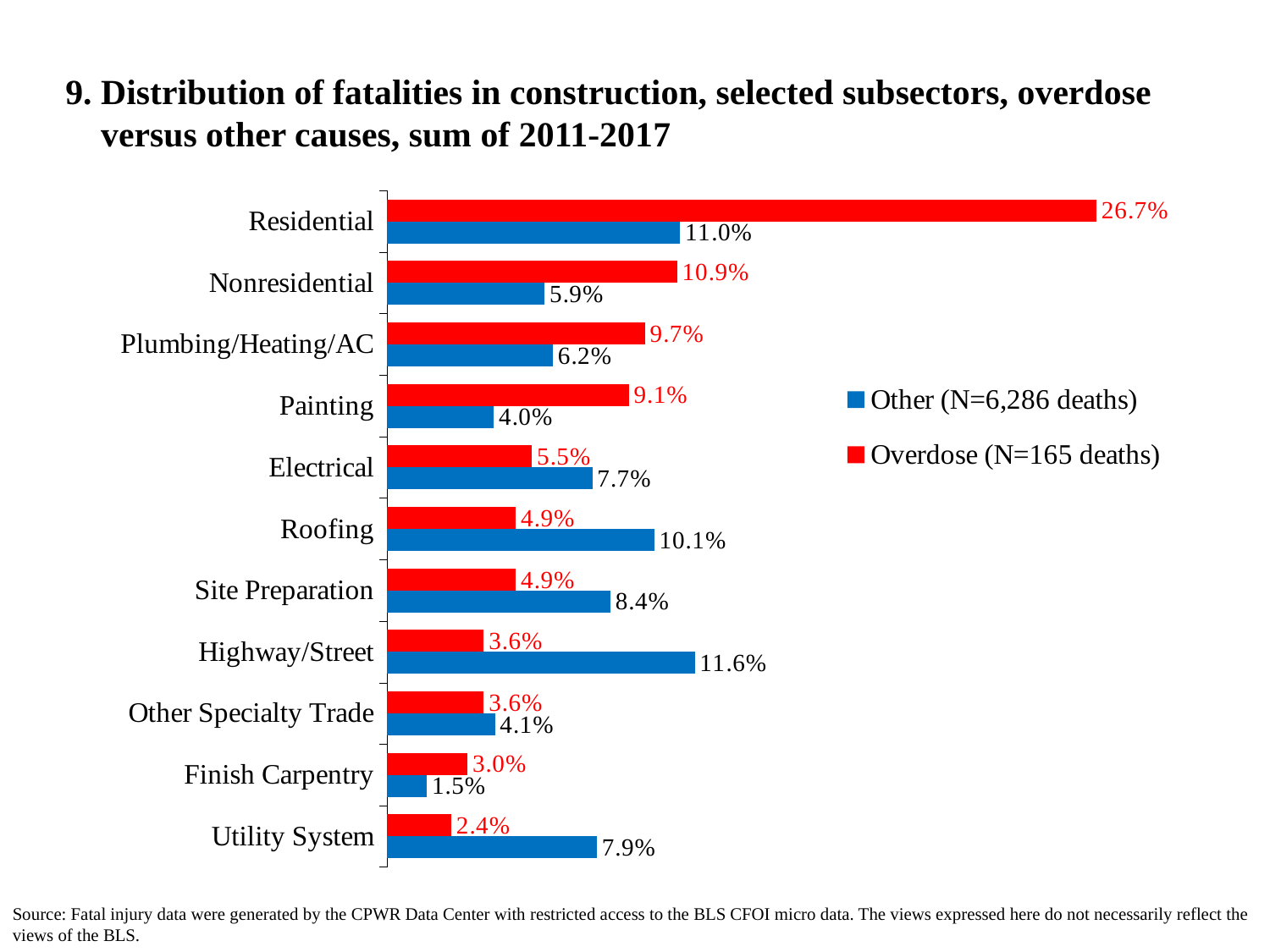
Which subsector has the highest Overdose value? Residential Which subsector has the lowest Other value? Finish Carpentry Which is larger for Roofing, the Overdose value or the Other value? Other How many subsectors are shown on the chart? 11 What is the Other value for Highway/Street? 11.6% According to the legend, how many deaths does the Overdose series represent? 165 What is the difference between the Other values for Highway/Street and Other Specialty Trade? 7.5% What is the Overdose value for Painting? 9.1% What is the difference between the Overdose and Other values for Residential? 15.7% What is the Overdose value for Residential? 26.7% How many series does the legend list? 2 What kind of chart is shown on the slide? Bar chart